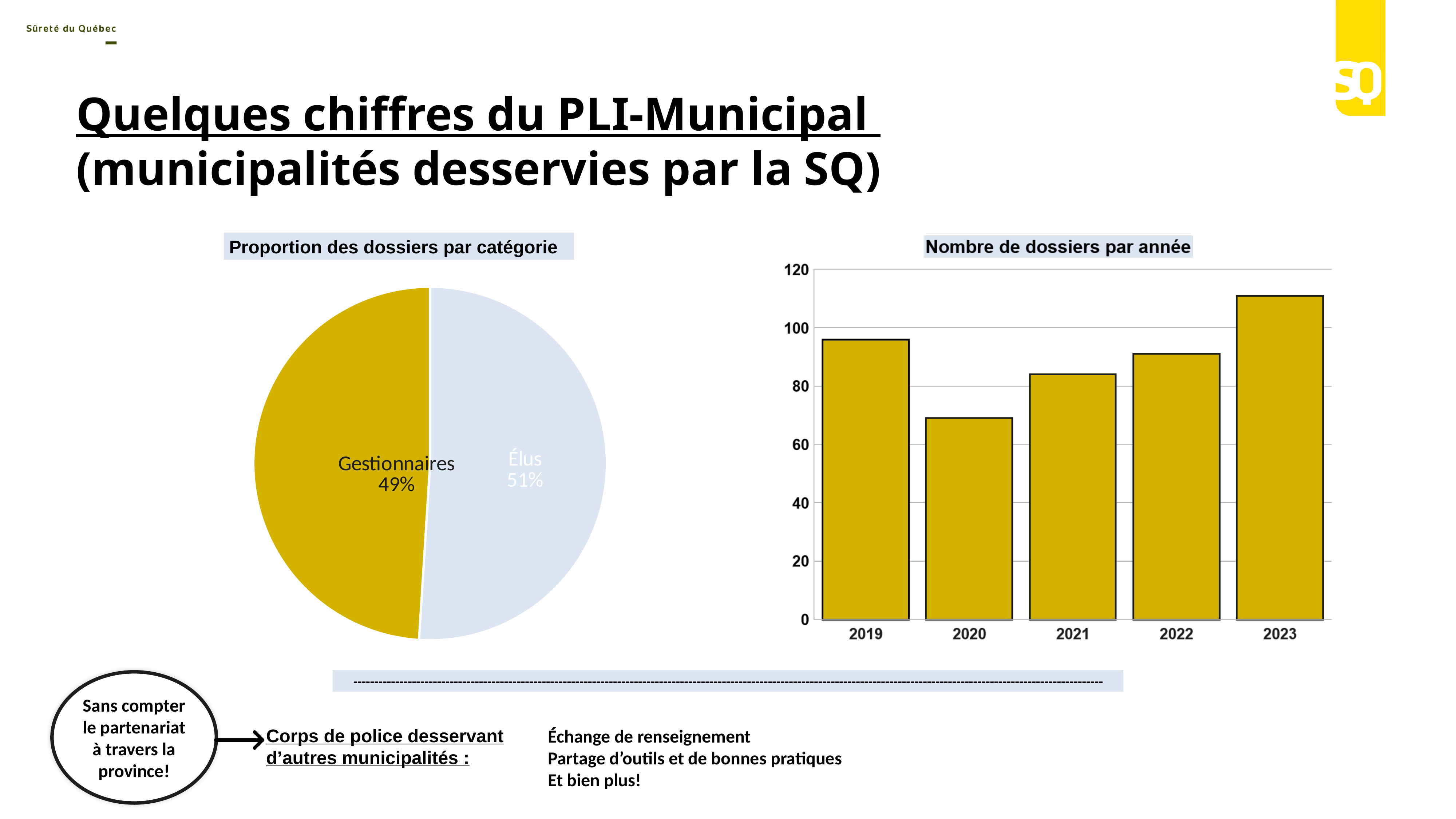
In the chart 'Proportion des dossiers par catégorie', how many slices does the pie have? 2 In the chart 'Nombre de dossiers par année', which year has the highest number of dossiers? 2023 In the chart 'Nombre de dossiers par année', how many years are shown on the x axis? 5 In the chart 'Nombre de dossiers par année', do the values rise or fall from 2020 to 2023? rise In the chart 'Nombre de dossiers par année', which year has the larger value, 2019 or 2021? 2019 In the chart 'Nombre de dossiers par année', is the value for 2023 greater or less than 100? greater In the chart 'Proportion des dossiers par catégorie', what share of the pie is Élus? 51% In the chart 'Proportion des dossiers par catégorie', which slice is larger, Gestionnaires or Élus? Élus In the chart 'Proportion des dossiers par catégorie', what share of the pie is Gestionnaires? 49% What kind of chart is 'Nombre de dossiers par année'? Bar chart In the chart 'Nombre de dossiers par année', is the value for 2020 greater or less than 80? less In the chart 'Nombre de dossiers par année', which year has the lowest number of dossiers? 2020